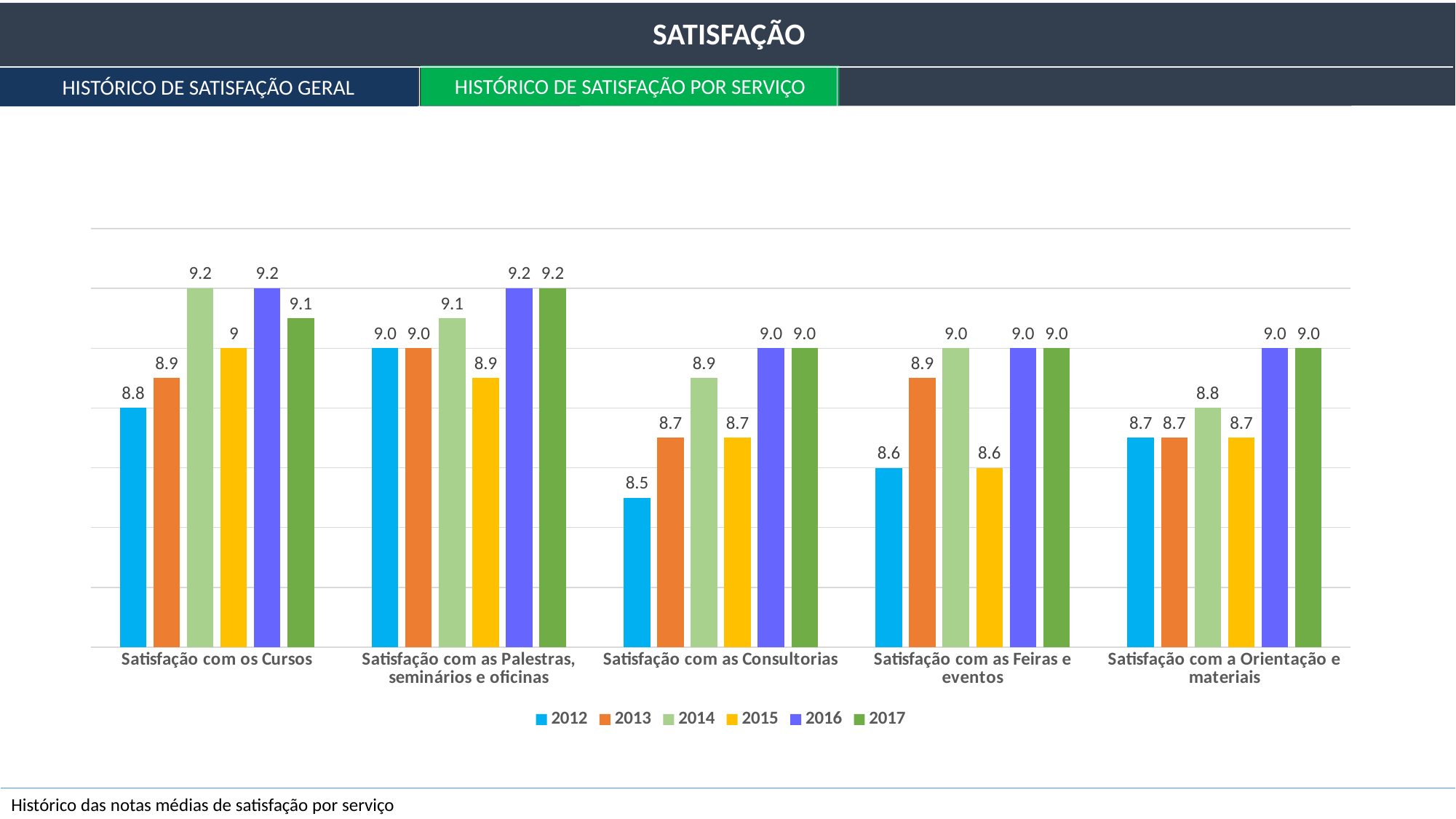
Which is larger for Satisfação com as Feiras e eventos: the 2013 value or the 2015 value? 2013 What type of chart is shown on the slide? Bar chart What is the 2015 value for Satisfação com os Cursos? 9 How many service categories are shown on the x axis? 5 Which year has the lowest value for Satisfação com as Consultorias? 2012 What is the 2012 value for Satisfação com as Consultorias? 8.5 What is the 2014 value for Satisfação com a Orientação e materiais? 8.8 Do the values for Satisfação com as Consultorias generally rise or fall from 2012 to 2017? Rise How many series does the legend list? 6 What is the difference between the 2017 and 2012 values for Satisfação com as Consultorias? 0.5 What is the 2012 value for Satisfação com os Cursos? 8.8 Which tab is highlighted in green above the chart? HISTÓRICO DE SATISFAÇÃO POR SERVIÇO